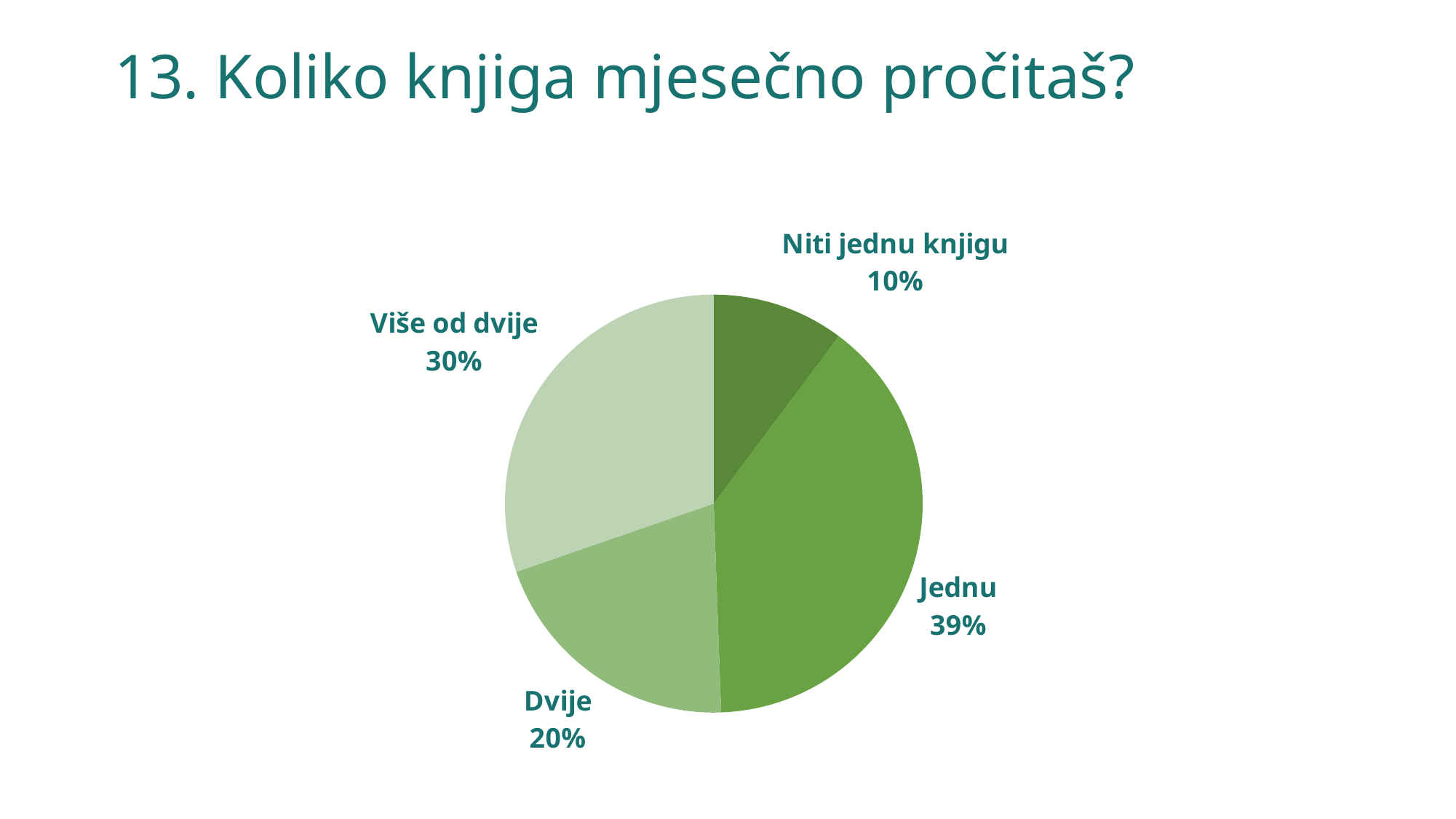
What share of the pie does "Jednu" have? 39% What share of the pie does "Više od dvije" have? 30% What is the title of the slide? 13. Koliko knjiga mjesečno pročitaš? What share of the pie does "Niti jednu knjigu" have? 10% Which category has the smallest slice of the pie? Niti jednu knjigu What kind of chart is shown on the slide? pie chart What is the difference in percentage points between "Više od dvije" and "Niti jednu knjigu"? 20 How many slices does the pie chart have? 4 What is the difference in percentage points between "Jednu" and "Dvije"? 19 Which is larger, the share for "Više od dvije" or the share for "Dvije"? Više od dvije Which category has the largest slice of the pie? Jednu